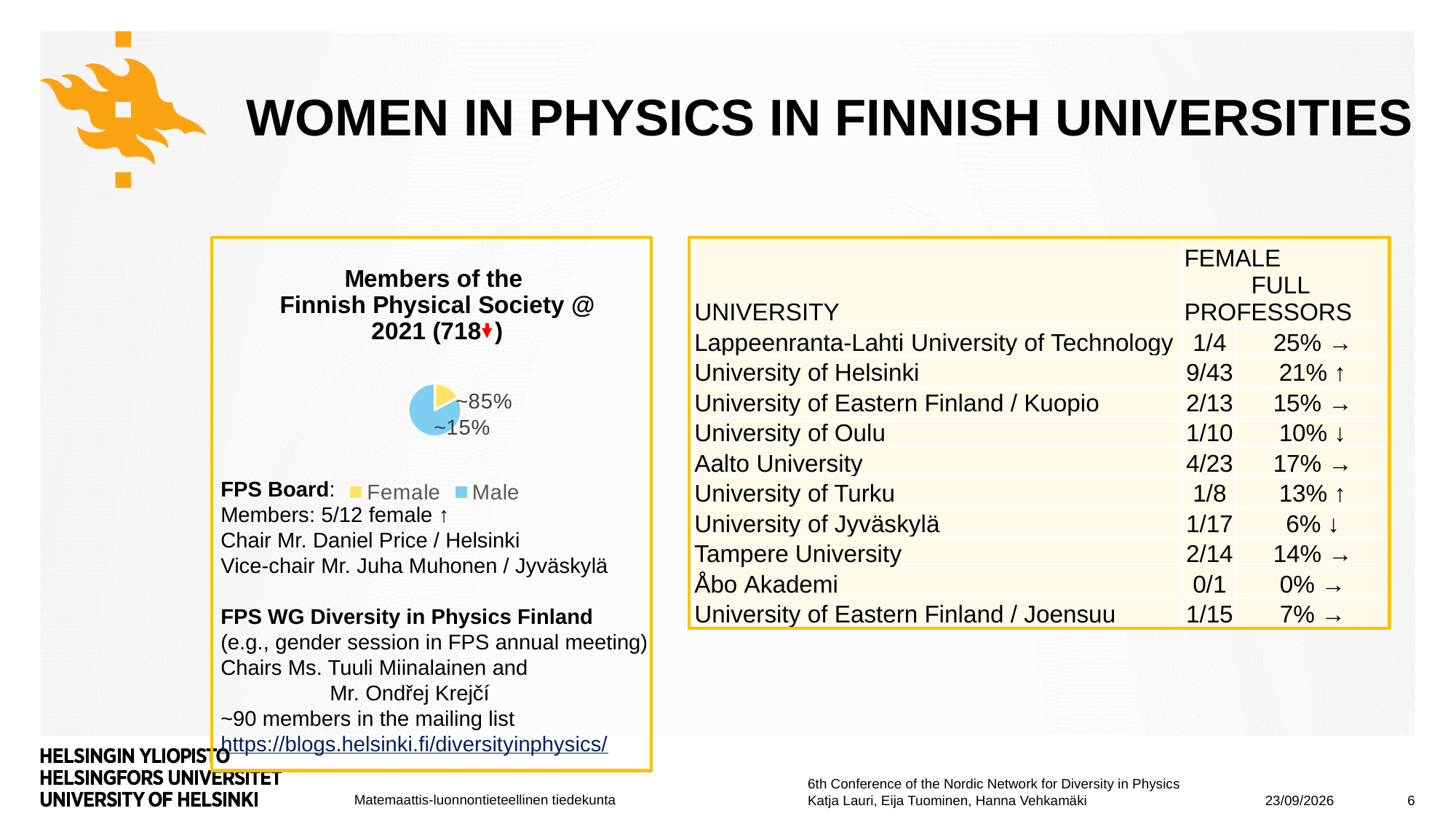
Which category in the pie chart is labelled ~85%? Male Which category has the smallest slice in the pie chart? Female How many entries does the legend of the pie chart list? 2 Which category in the pie chart is labelled ~15%? Female In the pie chart, which slice is larger, Female or Male? Male What kind of chart is shown on the slide? pie chart How many slices does the pie chart have? 2 What colour is the Female slice in the pie chart? yellow Which category has the largest slice in the pie chart? Male What is the title of the pie chart? Members of the Finnish Physical Society @ 2021 (718↓)